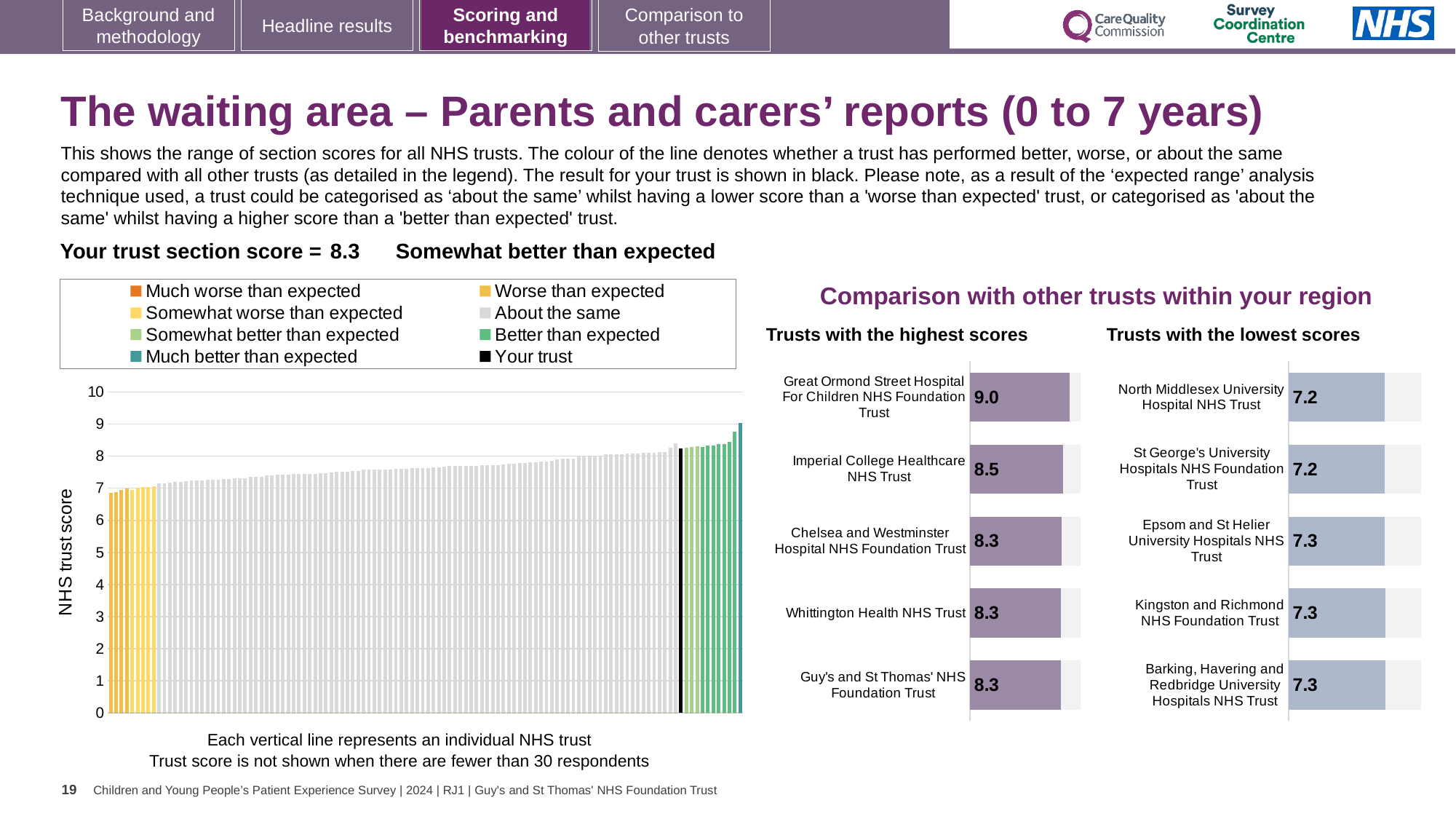
How many trusts are shown in the 'Trusts with the highest scores' chart? 5 In the large chart on the left, do the trust scores rise or fall from left to right? rise In the 'Trusts with the lowest scores' chart, which is larger: the score for Epsom and St Helier University Hospitals NHS Trust or the score for North Middlesex University Hospital NHS Trust? Epsom and St Helier University Hospitals NHS Trust In the large chart on the left, is the value of the black bar (Your trust) greater or less than 8? greater What kind of chart is the large chart on the left with the y-axis labelled 'NHS trust score'? bar chart How many entries does the legend above the large chart on the left list? 8 In the 'Trusts with the highest scores' chart, which trust has the highest score? Great Ormond Street Hospital For Children NHS Foundation Trust In the large chart on the left, is the value of the leftmost bar greater or less than 7? less In the 'Trusts with the highest scores' chart, what is the score for Great Ormond Street Hospital For Children NHS Foundation Trust? 9.0 In the 'Trusts with the lowest scores' chart, what is the difference between the scores of Barking, Havering and Redbridge University Hospitals NHS Trust and St George's University Hospitals NHS Foundation Trust? 0.1 In the 'Trusts with the highest scores' chart, what is the difference between the scores of Great Ormond Street Hospital For Children NHS Foundation Trust and Imperial College Healthcare NHS Trust? 0.5 In the 'Trusts with the lowest scores' chart, what is the score for Kingston and Richmond NHS Foundation Trust? 7.3